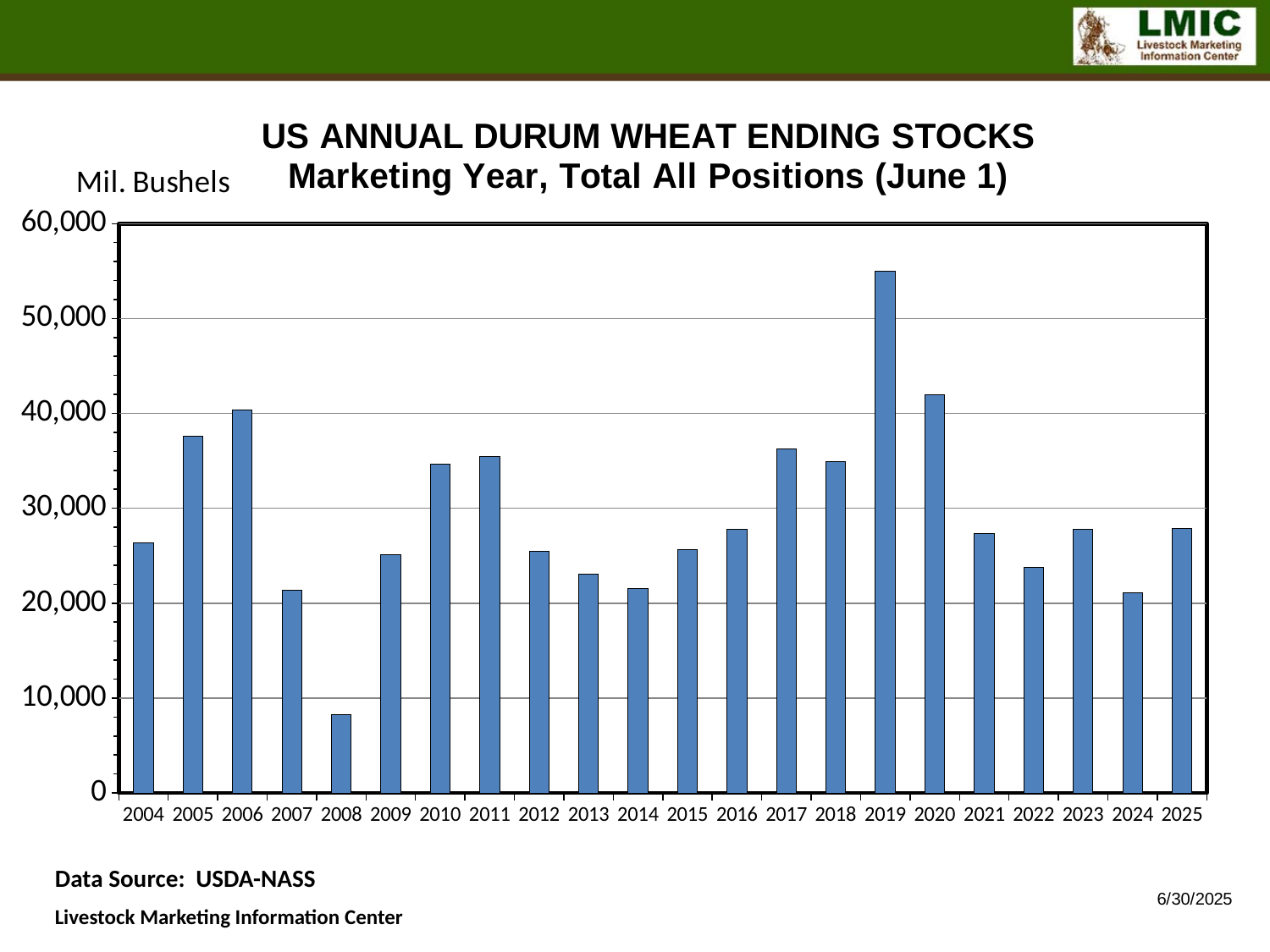
What kind of chart is shown on the slide? bar chart Which year has the larger value, 2019 or 2020? 2019 Do the values rise or fall from 2019 to 2022? fall Which year has the lowest durum wheat ending stocks? 2008 Is the value for 2008 greater or less than 10,000? less Which year has the larger value, 2007 or 2008? 2007 Is the value for 2024 greater or less than 30,000? less What unit is shown on the vertical axis label? Mil. Bushels Which year has the highest durum wheat ending stocks? 2019 Is the value for 2019 greater or less than 50,000? greater How many years are plotted on the chart? 22